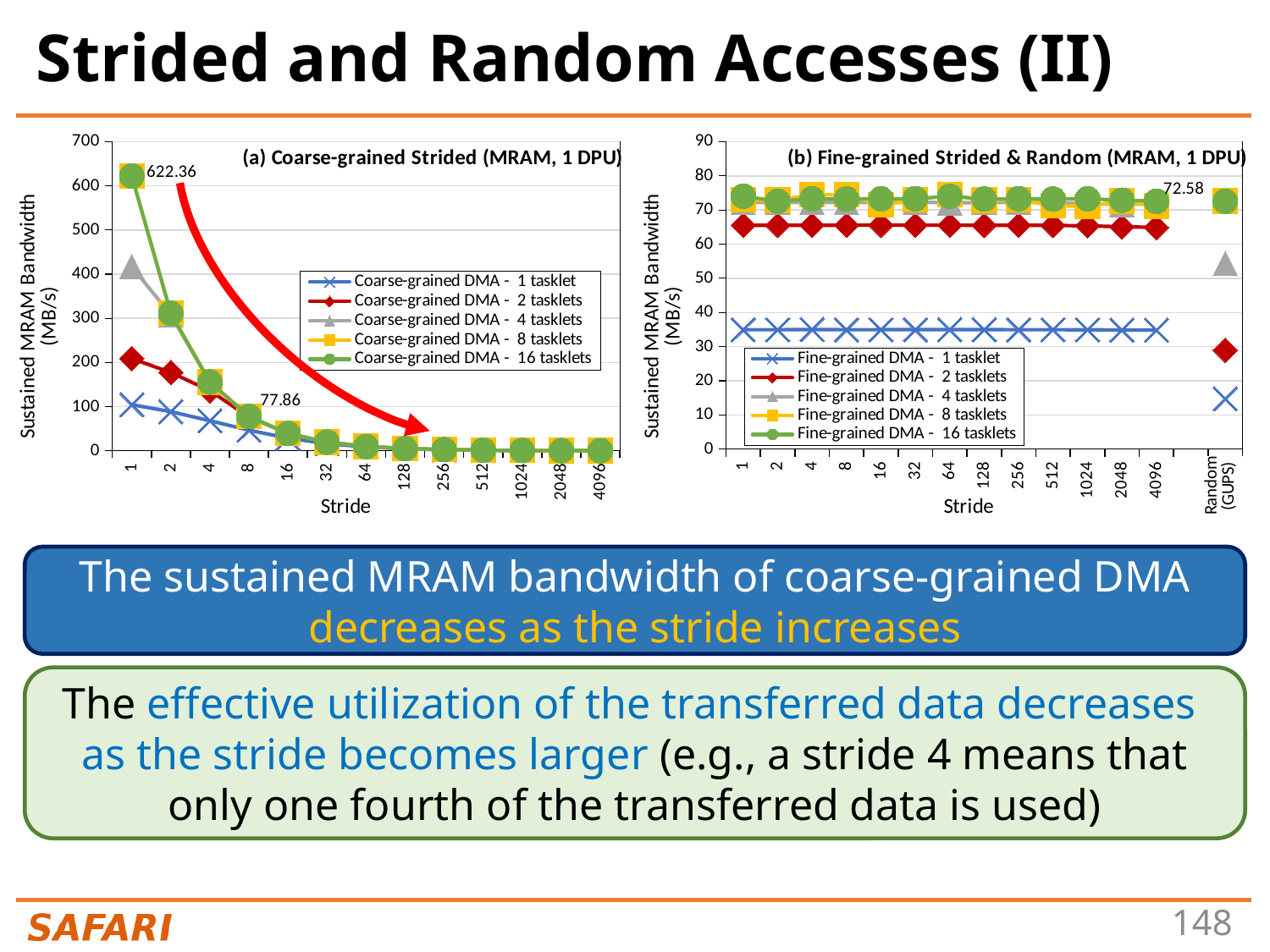
In chart (b) Fine-grained Strided & Random (MRAM, 1 DPU), is the value for Fine-grained DMA - 1 tasklet at Random (GUPS) greater or less than 20? less In chart (b) Fine-grained Strided & Random (MRAM, 1 DPU), is the value for Fine-grained DMA - 1 tasklet at stride 1 greater or less than 40? less In chart (b) Fine-grained Strided & Random (MRAM, 1 DPU), what value is labeled at the Random (GUPS) category? 72.58 In chart (a) Coarse-grained Strided (MRAM, 1 DPU), what is the labeled sustained MRAM bandwidth at stride 1 for the highest series? 622.36 In chart (a) Coarse-grained Strided (MRAM, 1 DPU), is the value for Coarse-grained DMA - 4 tasklets at stride 1 greater or less than 300? greater In chart (a) Coarse-grained Strided (MRAM, 1 DPU), which series has the lowest bandwidth at stride 1? Coarse-grained DMA - 1 tasklet In chart (a) Coarse-grained Strided (MRAM, 1 DPU), do the values for Coarse-grained DMA - 16 tasklets rise or fall as the stride increases? fall What kind of chart is chart (a) Coarse-grained Strided (MRAM, 1 DPU)? line chart How many series does the legend of chart (b) Fine-grained Strided & Random (MRAM, 1 DPU) list? 5 In chart (a) Coarse-grained Strided (MRAM, 1 DPU), how many stride values are shown on the x axis? 13